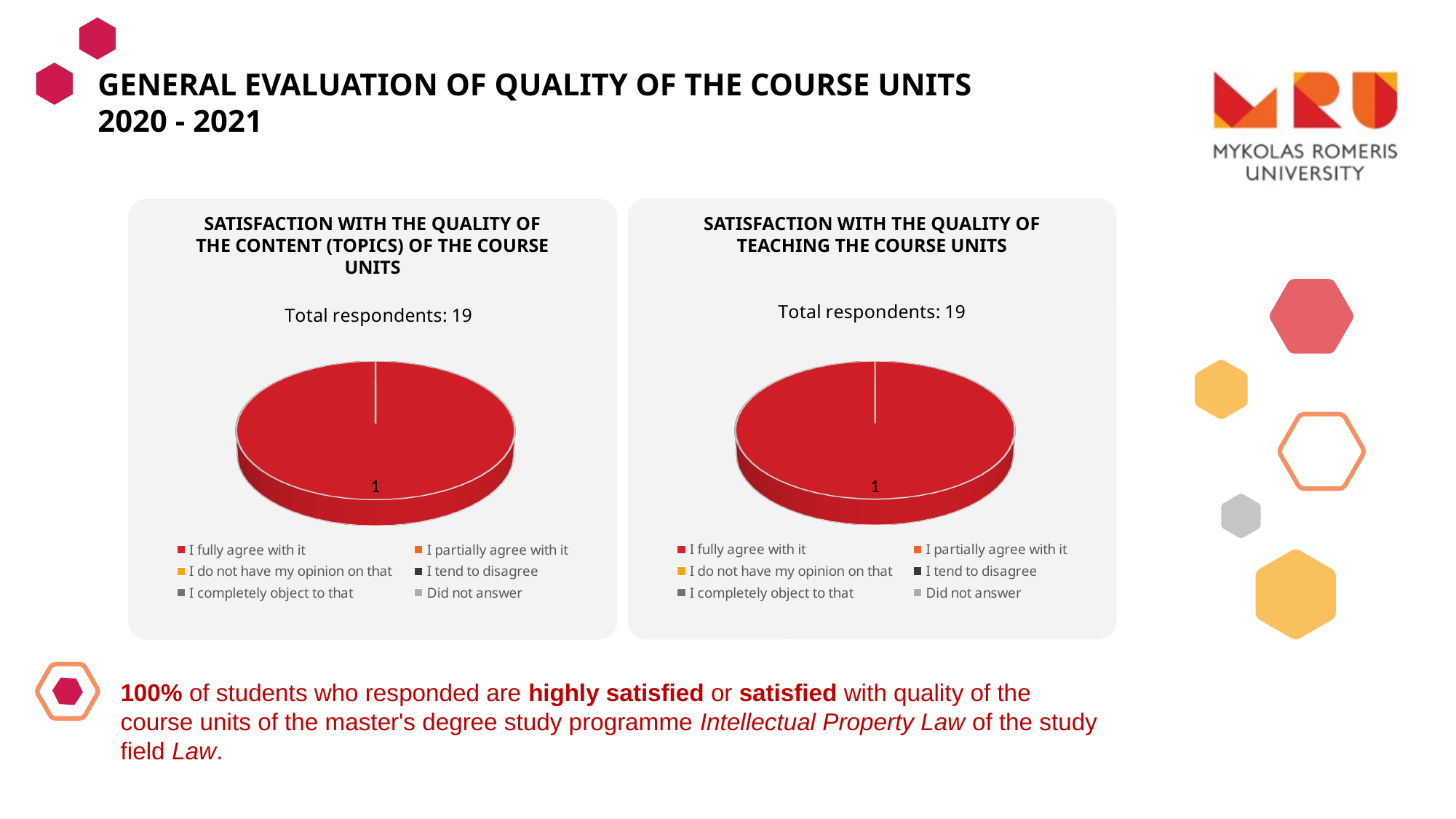
What kind of chart is shown under the title 'Satisfaction with the quality of the content (topics) of the course units'? pie chart In the left chart (satisfaction with the quality of the content of the course units), how many entries does the legend list? 6 In the left chart (satisfaction with the quality of the content of the course units), what share of the pie does the 'I fully agree with it' slice take up? 100% In the right chart (satisfaction with the quality of teaching the course units), which legend category does the single visible slice belong to? I fully agree with it In the right chart (satisfaction with the quality of teaching the course units), how many visible slices does the pie have? 1 In the right chart (satisfaction with the quality of teaching the course units), how many entries does the legend list? 6 What kind of chart is shown under the title 'Satisfaction with the quality of teaching the course units'? pie chart How many total respondents are stated for the left chart (satisfaction with the quality of the content of the course units)? 19 In the right chart (satisfaction with the quality of teaching the course units), what colour is the 'I fully agree with it' legend entry? red In the left chart (satisfaction with the quality of the content of the course units), what data label is printed on the pie slice? 1 In the left chart (satisfaction with the quality of the content of the course units), which legend category does the single visible slice belong to? I fully agree with it In the right chart (satisfaction with the quality of teaching the course units), what data label is printed on the pie slice? 1